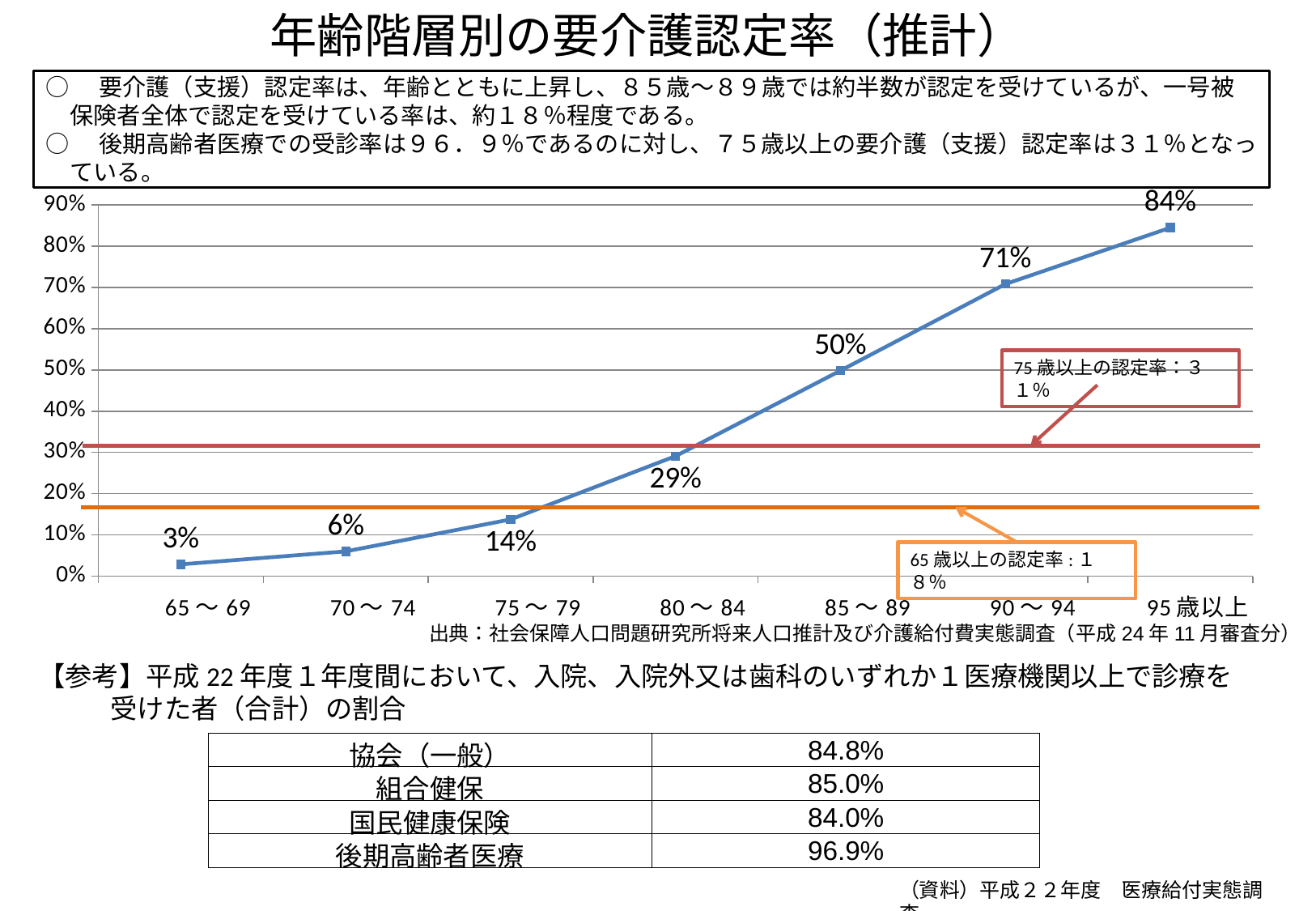
What is the difference between the certification rates of the 85～89 and 75～79 age groups? 36% What is the certification rate for the 95歳以上 age group? 84% Which has a higher certification rate, the 90～94 group or the 80～84 group? 90～94 Which age group has the highest certification rate? 95歳以上 Do the certification rates rise or fall as age increases along the x axis? rise Which age group has the lowest certification rate? 65～69 What is the certification rate for the 65～69 age group? 3% Is the certification rate for the 70～74 age group greater or less than 10%? less What certification rate does the red horizontal line (75歳以上の認定率) represent? 31% What kind of chart is used to show the certification rate by age group? line chart How many age groups are plotted on the x axis of the chart? 7 What is the certification rate for the 80～84 age group? 29%